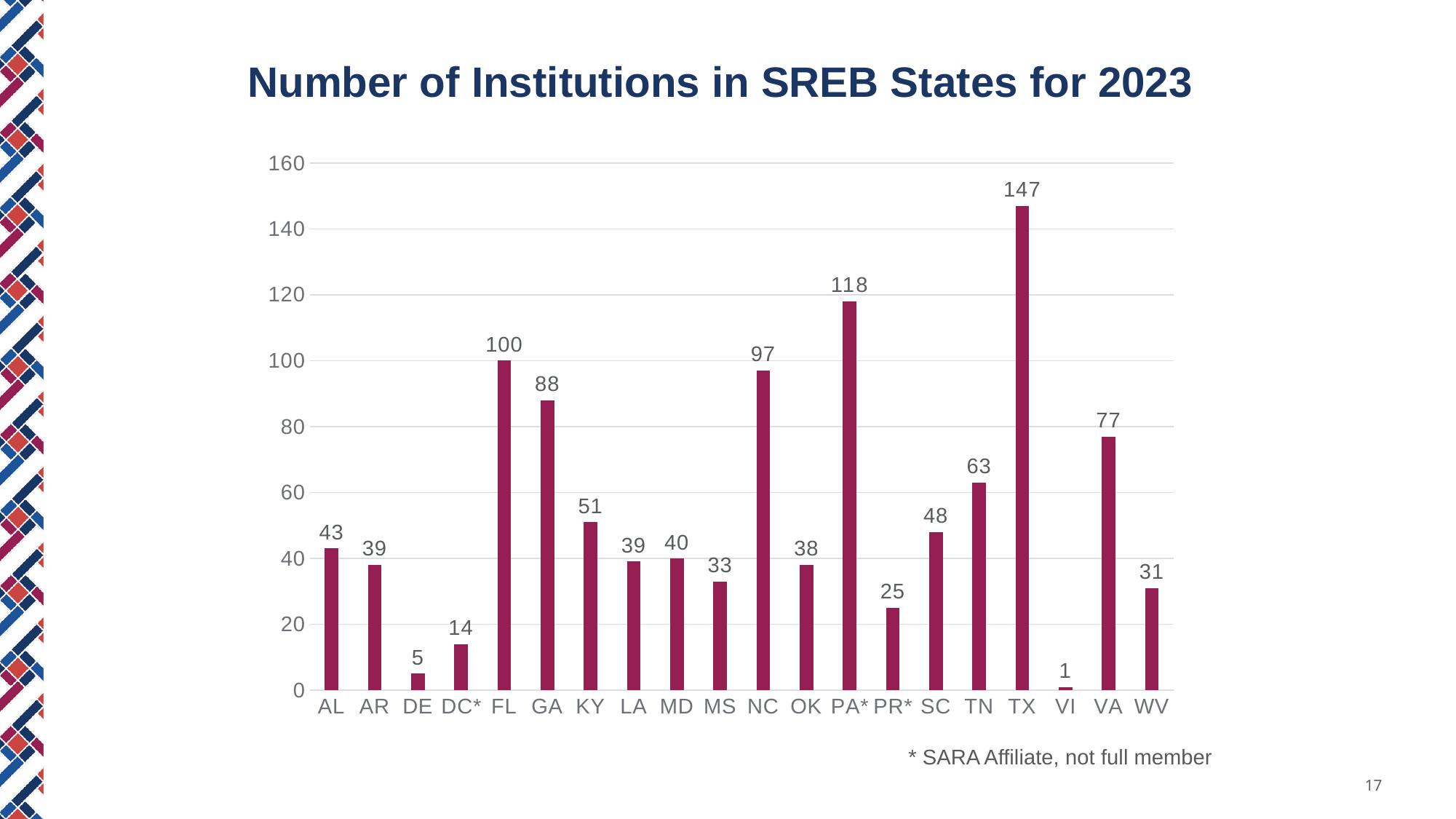
Which has more institutions, TN or KY? TN How many states are shown on the x axis? 20 What is the difference between the number of institutions in PA* and NC? 21 What does the asterisk after a state label indicate? SARA Affiliate, not full member What is the number of institutions for TX? 147 Is the value for SC greater or less than 60? less What is the number of institutions for GA? 88 What kind of chart is shown on the slide? Bar chart What is the difference between the number of institutions in FL and VA? 23 Which state has the lowest number of institutions? VI What is the number of institutions for PR*? 25 Which state has the highest number of institutions? TX